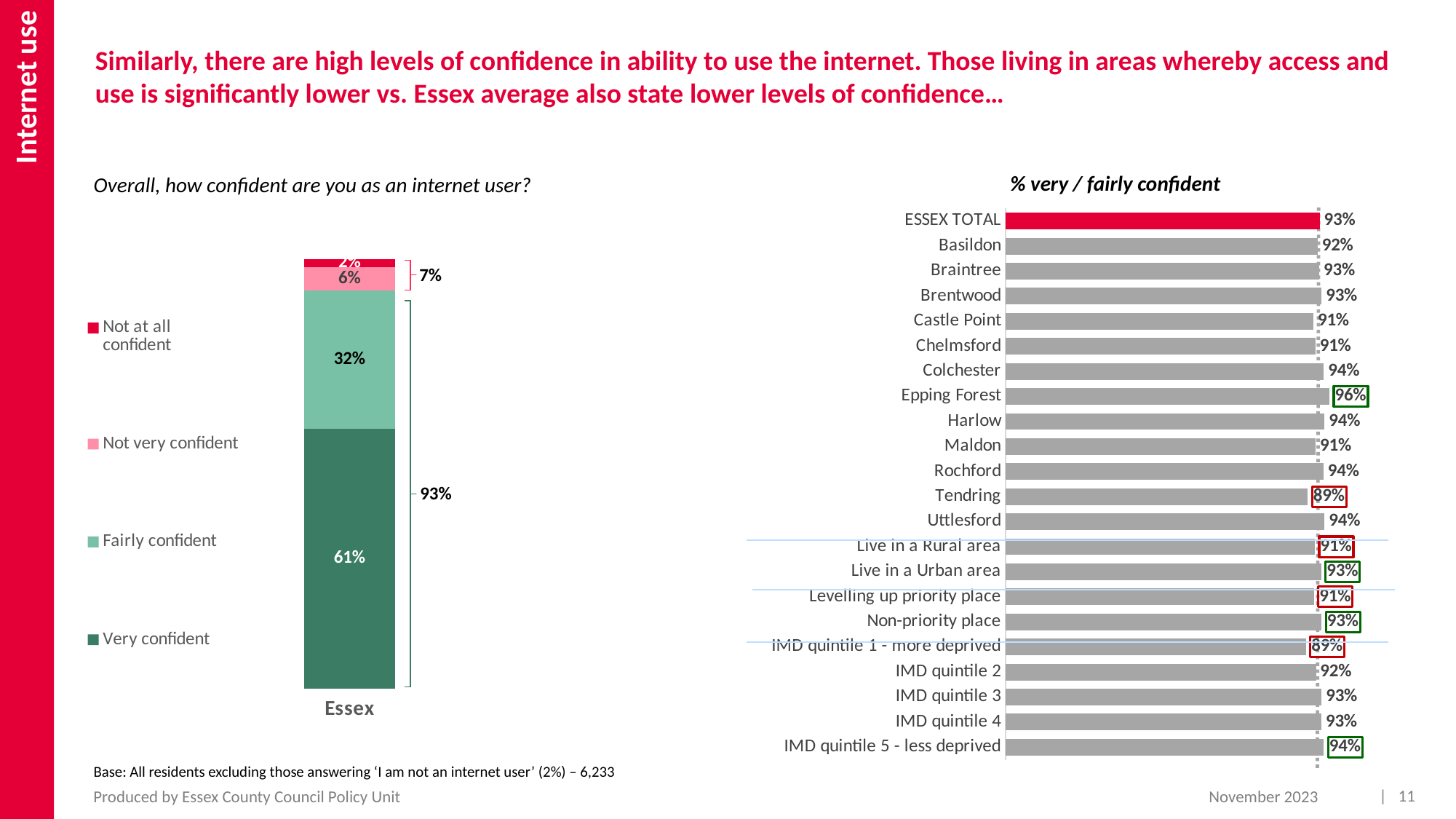
In the '% very / fairly confident' chart, which is larger: Live in a Rural area or Live in a Urban area? Live in a Urban area In the stacked bar chart on the left, what percentage of Essex residents are 'Fairly confident'? 32% In the '% very / fairly confident' chart, what is the value for Epping Forest? 96% In the '% very / fairly confident' chart, what is the value for ESSEX TOTAL? 93% In the '% very / fairly confident' chart, what is the value for IMD quintile 5 - less deprived? 94% In the stacked bar chart on the left, what percentage of Essex residents are 'Very confident'? 61% In the '% very / fairly confident' chart, which district has the highest value? Epping Forest What type of chart is the '% very / fairly confident' chart? Bar chart How many series does the legend of the stacked bar chart on the left list? 4 In the '% very / fairly confident' chart, what is the difference between Epping Forest and Tendring? 7% In the stacked bar chart on the left, what is the combined total of 'Very confident' and 'Fairly confident'? 93% In the '% very / fairly confident' chart, what is the value for Tendring? 89%